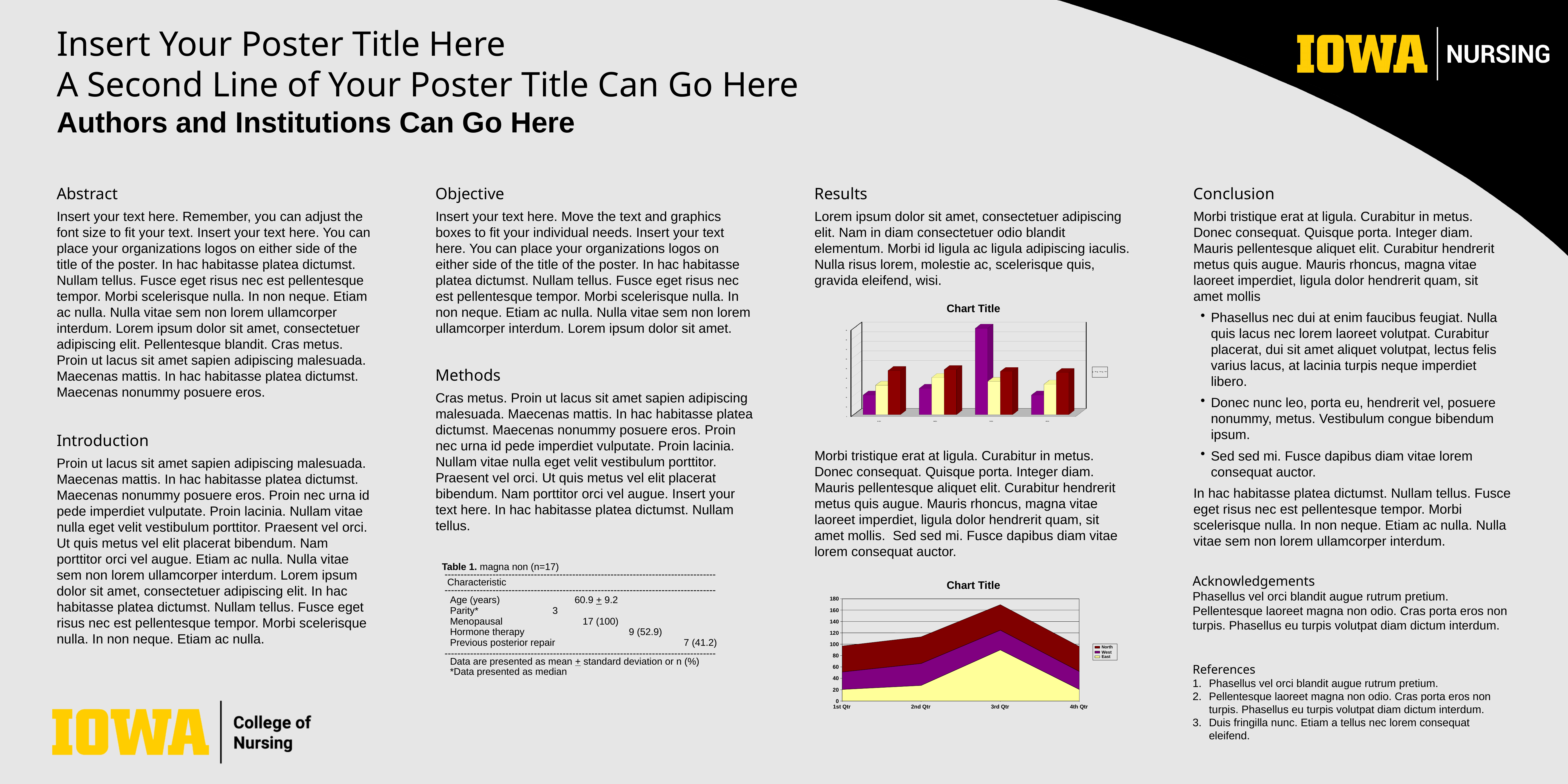
In the lower chart, which quarter has the highest stacked total? 3rd Qtr In the lower chart, is the East value at 1st Qtr greater or less than 40? less In the lower chart, what are the series named in the legend? North, West, East In the lower chart, does the stacked total rise or fall from 3rd Qtr to 4th Qtr? fall In the lower chart, does the East series rise or fall from 1st Qtr to 3rd Qtr? rise What kind of chart is the lower chart on the slide? area chart In the lower chart, how many series does the legend list? 3 What kind of chart is the upper chart on the slide? bar chart In the lower chart, is the stacked total at 3rd Qtr greater or less than 140? greater In the lower chart, is the East value at 3rd Qtr greater or less than 60? greater In the lower chart, how many categories are shown on the x axis? 4 In the upper chart, how many groups of bars are plotted along the x axis? 4